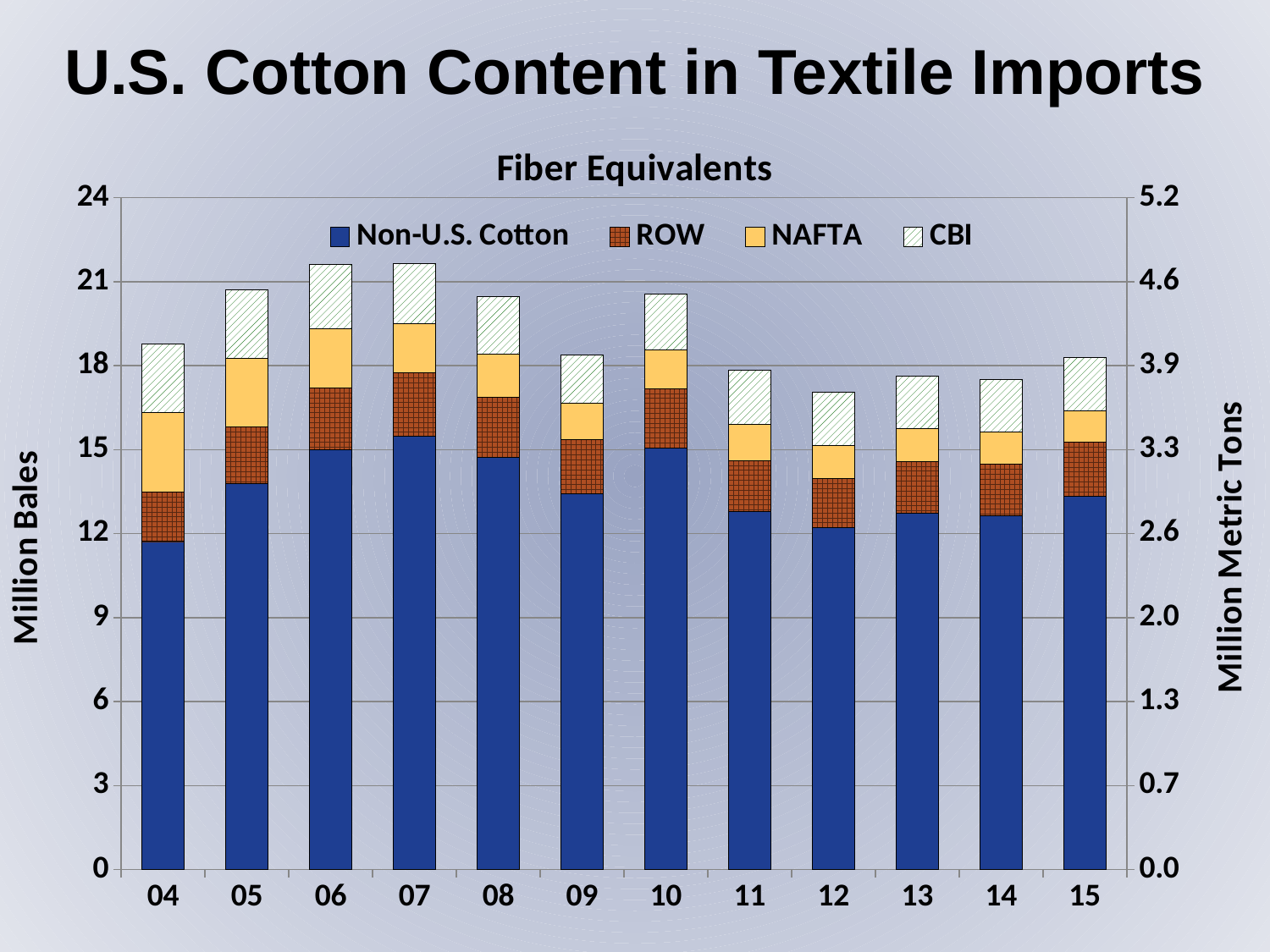
Which year has the taller total stacked bar, 04 or 05? 05 Is the Non-U.S. Cotton value for 04 greater or less than 12 million bales? less Is the Non-U.S. Cotton value for 07 greater or less than 15 million bales? greater How many years are shown along the x axis? 12 What is the label of the left vertical axis? Million Bales Which year has the lowest Non-U.S. Cotton value? 04 Is the total stacked bar for 12 greater or less than 18 million bales? less Which year has the taller total stacked bar, 10 or 11? 10 Do the total stacked bars rise or fall from 10 to 12? fall How many series does the legend list? 4 What kind of chart is shown on the slide? Stacked bar chart